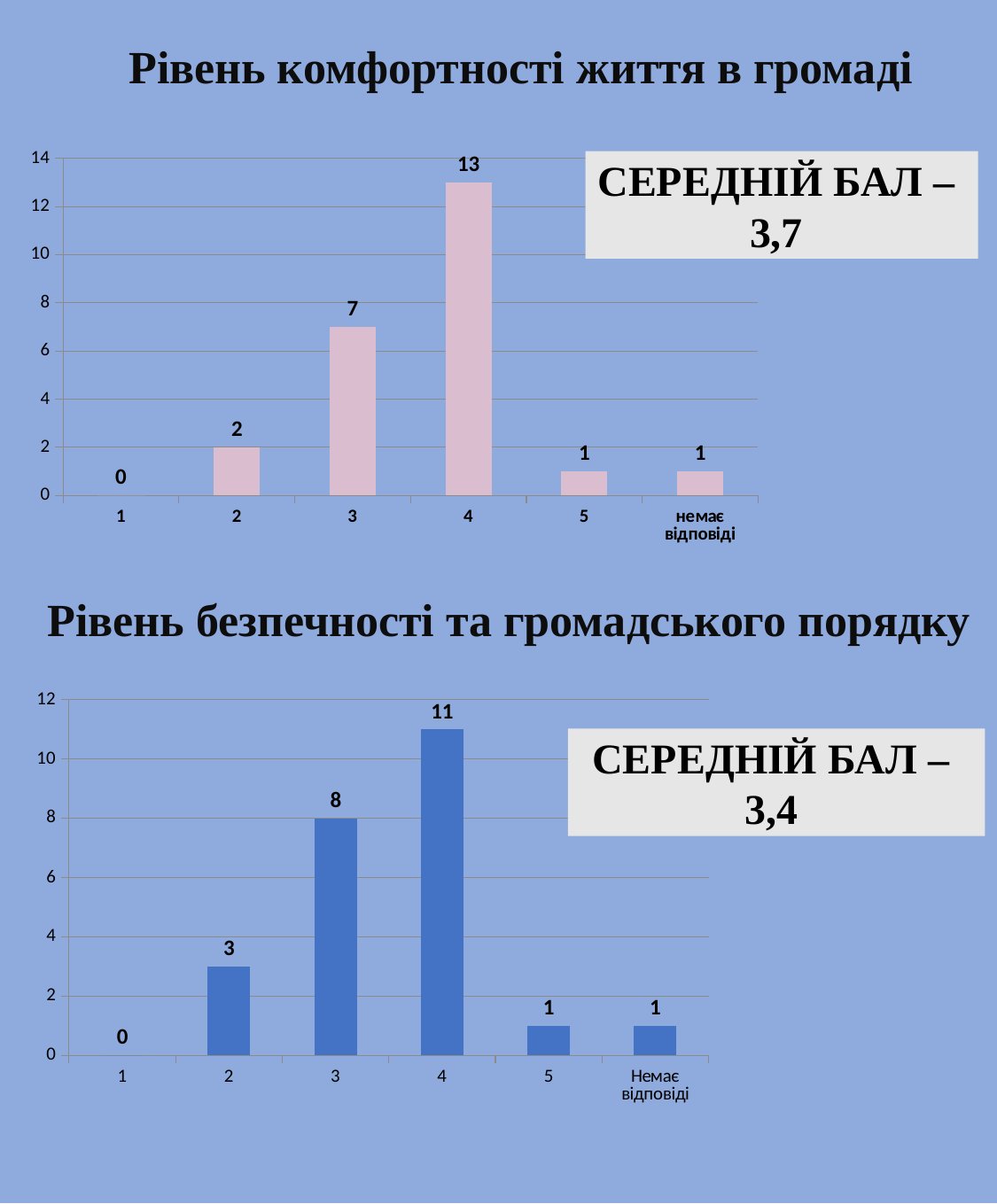
In the top chart 'Рівень комфортності життя в громаді', what is the difference between the values for categories 4 and 3? 6 In the bottom chart 'Рівень безпечності та громадського порядку', what is the value for category 2? 3 In the top chart 'Рівень комфортності життя в громаді', which category has the highest value? 4 In the bottom chart 'Рівень безпечності та громадського порядку', what is the value for category 4? 11 In the bottom chart 'Рівень безпечності та громадського порядку', what is the difference between the values for categories 4 and 3? 3 In the bottom chart 'Рівень безпечності та громадського порядку', which category has the highest value? 4 In the top chart 'Рівень комфортності життя в громаді', what is the value for category 4? 13 What kind of chart is the bottom chart 'Рівень безпечності та громадського порядку'? bar chart In the top chart 'Рівень комфортності життя в громаді', which category has the lowest value? 1 In the bottom chart 'Рівень безпечності та громадського порядку', which is larger, the value for category 3 or category 2? 3 In the top chart 'Рівень комфортності життя в громаді', what is the value for category 3? 7 In the top chart 'Рівень комфортності життя в громаді', how many categories are shown on the x axis? 6